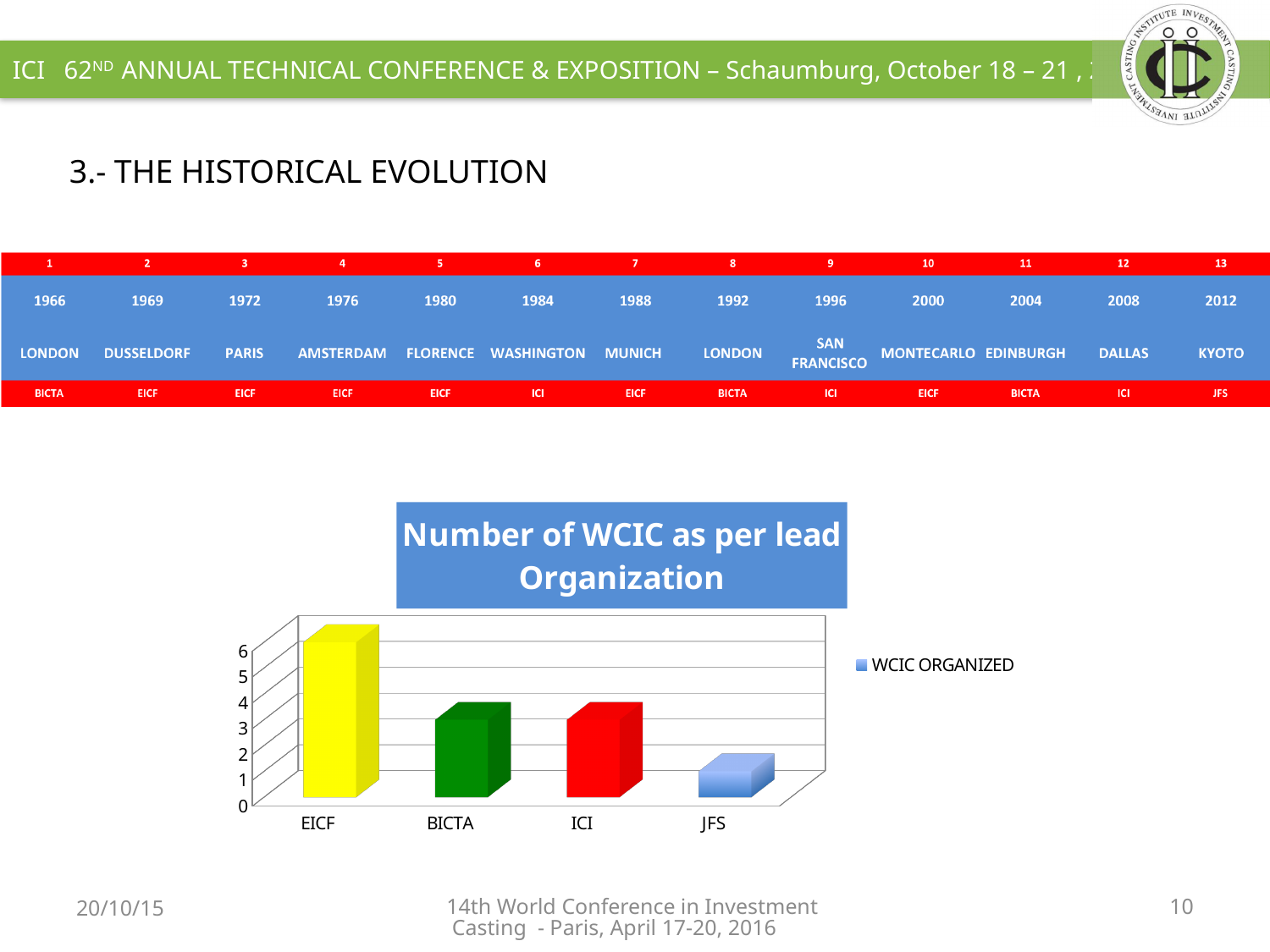
How many series does the chart legend list? 1 Is the value for JFS greater or less than 2? less Which organization has the highest bar in the chart? EICF How many categories are shown on the x axis of the chart? 4 Is the value for ICI greater or less than 2? greater What is the name of the series in the chart legend? WCIC ORGANIZED What kind of chart is shown on the slide? bar chart What is the title of the chart? Number of WCIC as per lead Organization Is the value for BICTA greater or less than 4? less Which is larger, the value for EICF or the value for ICI? EICF Which organization has the lowest bar in the chart? JFS